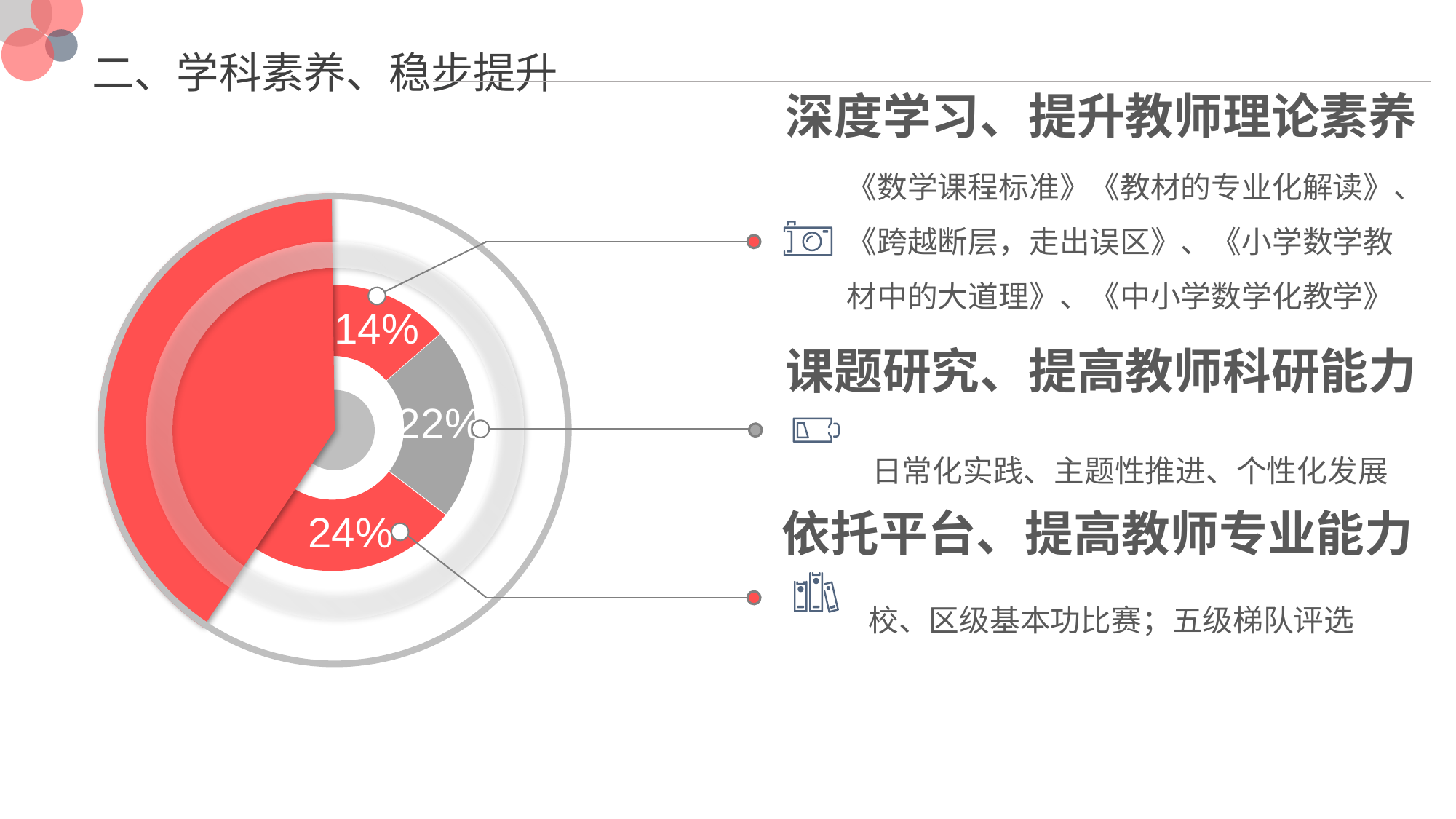
Which of the labeled slices has the smallest percentage? 14% What is the combined percentage of the three labeled slices? 60% What percentage is shown for the slice linked to 深度学习、提升教师理论素养? 14% What percentage is shown for the slice linked to 依托平台、提高教师专业能力? 24% What is the difference between the 22% slice and the 14% slice? 8% What colour is the 22% slice of the pie chart? gray What kind of chart is shown on the slide? doughnut chart Which is larger, the slice for 课题研究、提高教师科研能力 or the slice for 深度学习、提升教师理论素养? 课题研究、提高教师科研能力 How many slices in the pie chart have a percentage label printed on them? 3 What is the difference between the 24% slice and the 14% slice? 10% What percentage is shown for the slice linked to 课题研究、提高教师科研能力? 22% Which of the labeled slices has the largest percentage? 24%